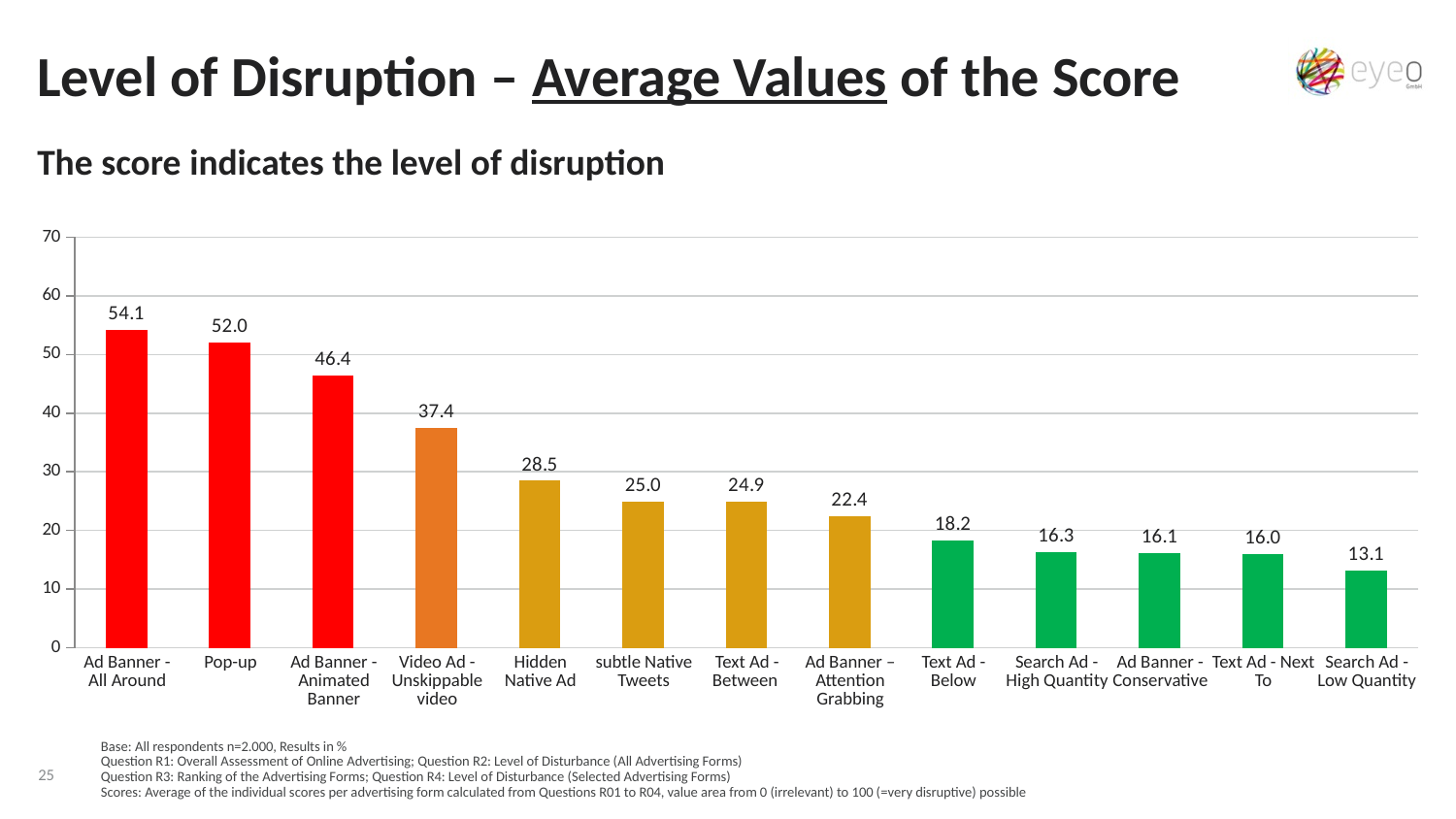
Which advertising form has the highest average disruption score? Ad Banner - All Around Which advertising form has the lowest average disruption score? Search Ad - Low Quantity Is the score for Ad Banner – Attention Grabbing greater or less than 20? greater What is the average disruption score for Text Ad - Below? 18.2 Do the scores rise or fall from left to right across the chart? fall What is the average disruption score for Video Ad - Unskippable video? 37.4 What is the average disruption score for Pop-up? 52.0 Which has a higher score, Ad Banner - Animated Banner or Video Ad - Unskippable video? Ad Banner - Animated Banner What is the difference between the scores for Hidden Native Ad and Search Ad - Low Quantity? 15.4 How many advertising forms are shown in the chart? 13 What kind of chart is shown on the slide? bar chart What is the difference between the scores for Ad Banner - All Around and Pop-up? 2.1